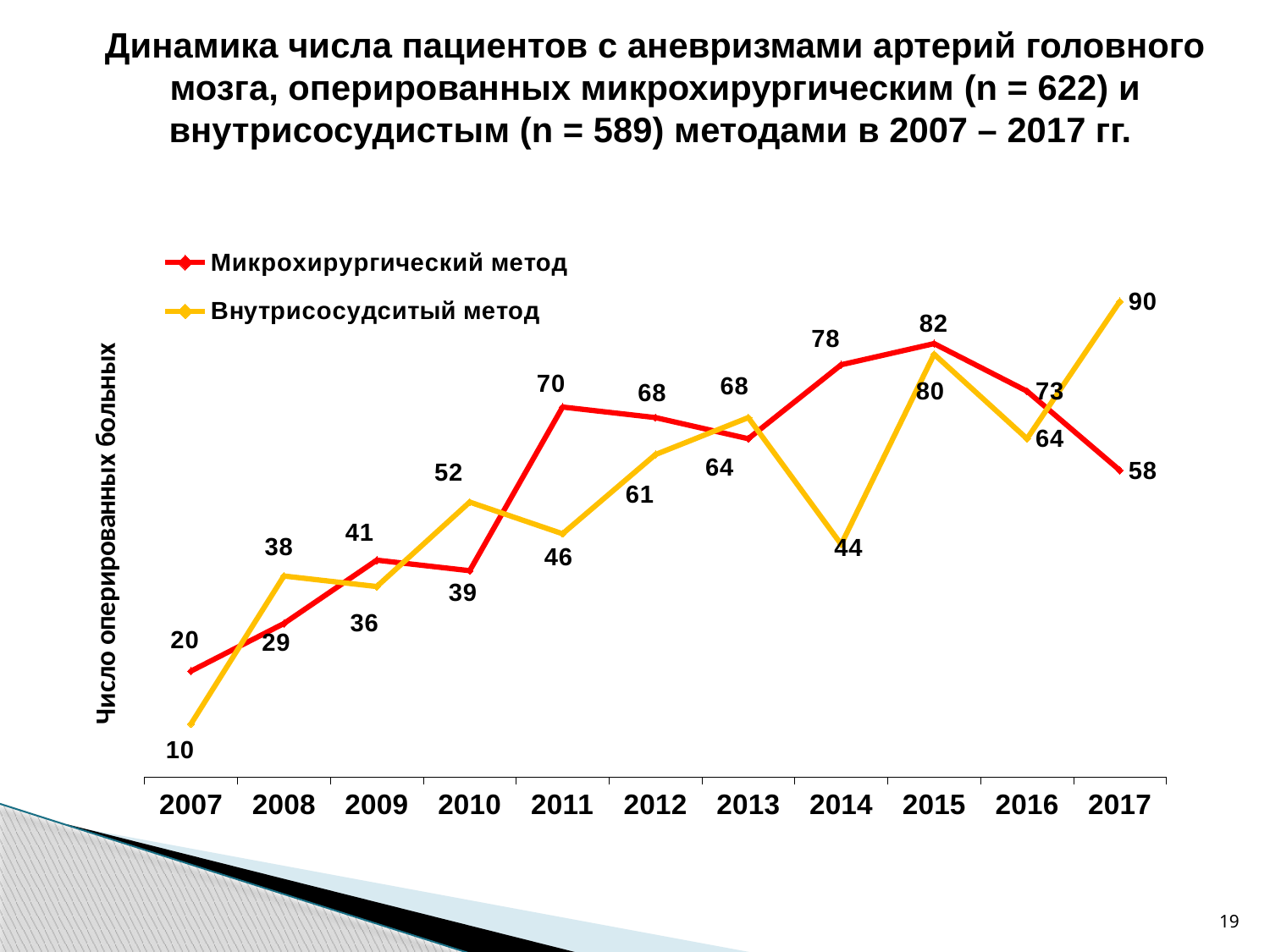
What is the value for the Микрохирургический метод series in 2007? 20 Which series has the larger value in 2017, Микрохирургический метод or Внутрисосудситый метод? Внутрисосудситый метод What is the difference between the Микрохирургический метод and Внутрисосудситый метод values in 2014? 34 In which year does the Внутрисосудситый метод series reach its highest value? 2017 How many series does the legend list? 2 In which year does the Микрохирургический метод series reach its highest value? 2015 What is the value for the Внутрисосудситый метод series in 2014? 44 What kind of chart is shown on the slide? line chart How many years are shown on the x axis? 11 What is the y-axis label of the chart? Число оперированных больных What is the value for the Микрохирургический метод series in 2011? 70 In which year is the Внутрисосудситый метод series at its lowest value? 2007